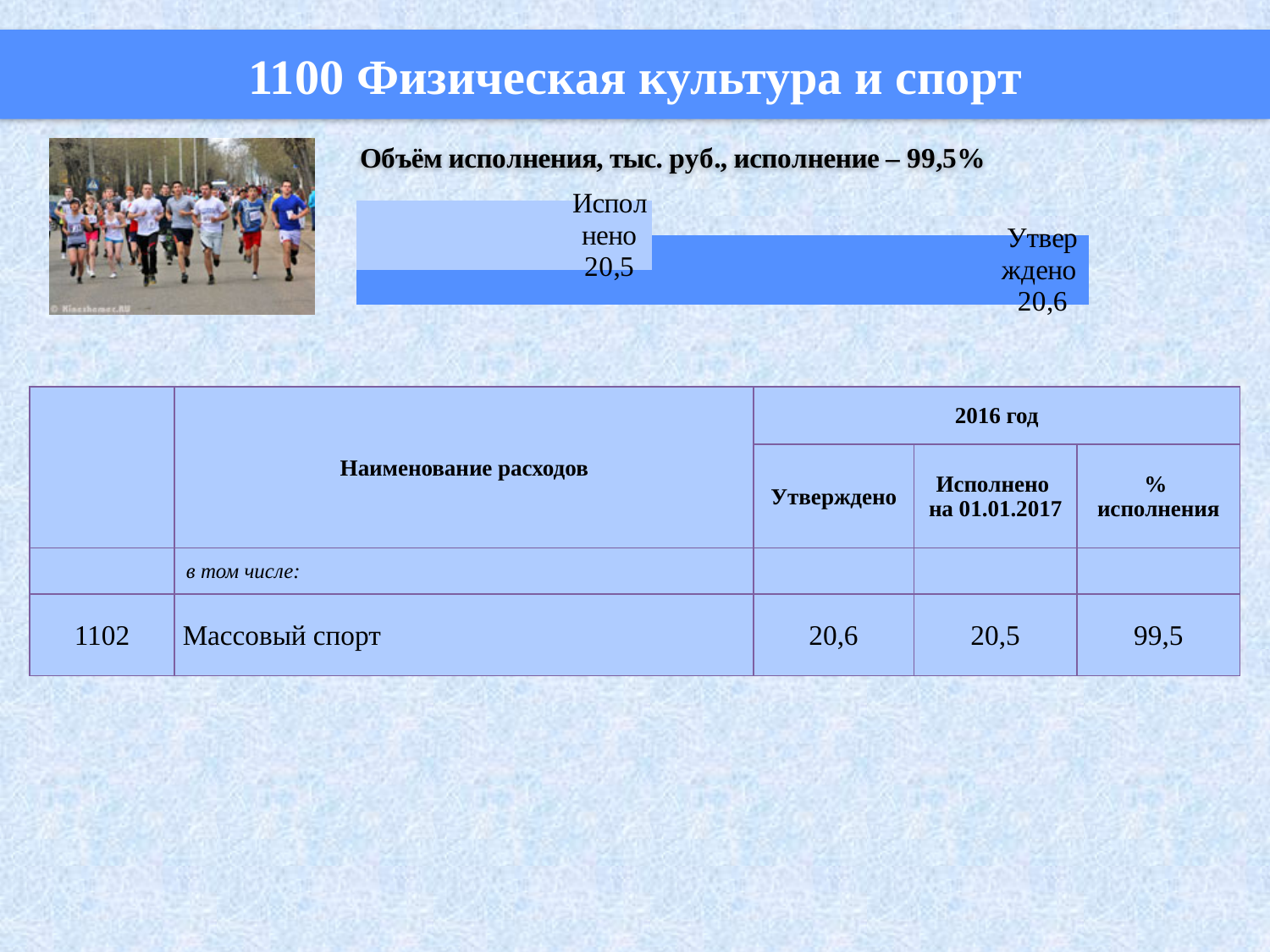
What is the title of the chart? Объём исполнения, тыс. руб., исполнение – 99,5% What is the value of the "Утверждено" bar in the chart? 20,6 Which bar in the chart has the lowest value? Исполнено What is the value of the "Исполнено" bar in the chart? 20,5 How many bars are plotted in the chart? 2 What is the difference between the "Утверждено" and "Исполнено" values in the chart? 0,1 Which bar in the chart has the highest value? Утверждено What execution percentage is stated in the chart title? 99,5% What type of chart is shown on the slide? bar chart Which bar in the chart has the higher value, "Утверждено" or "Исполнено"? Утверждено